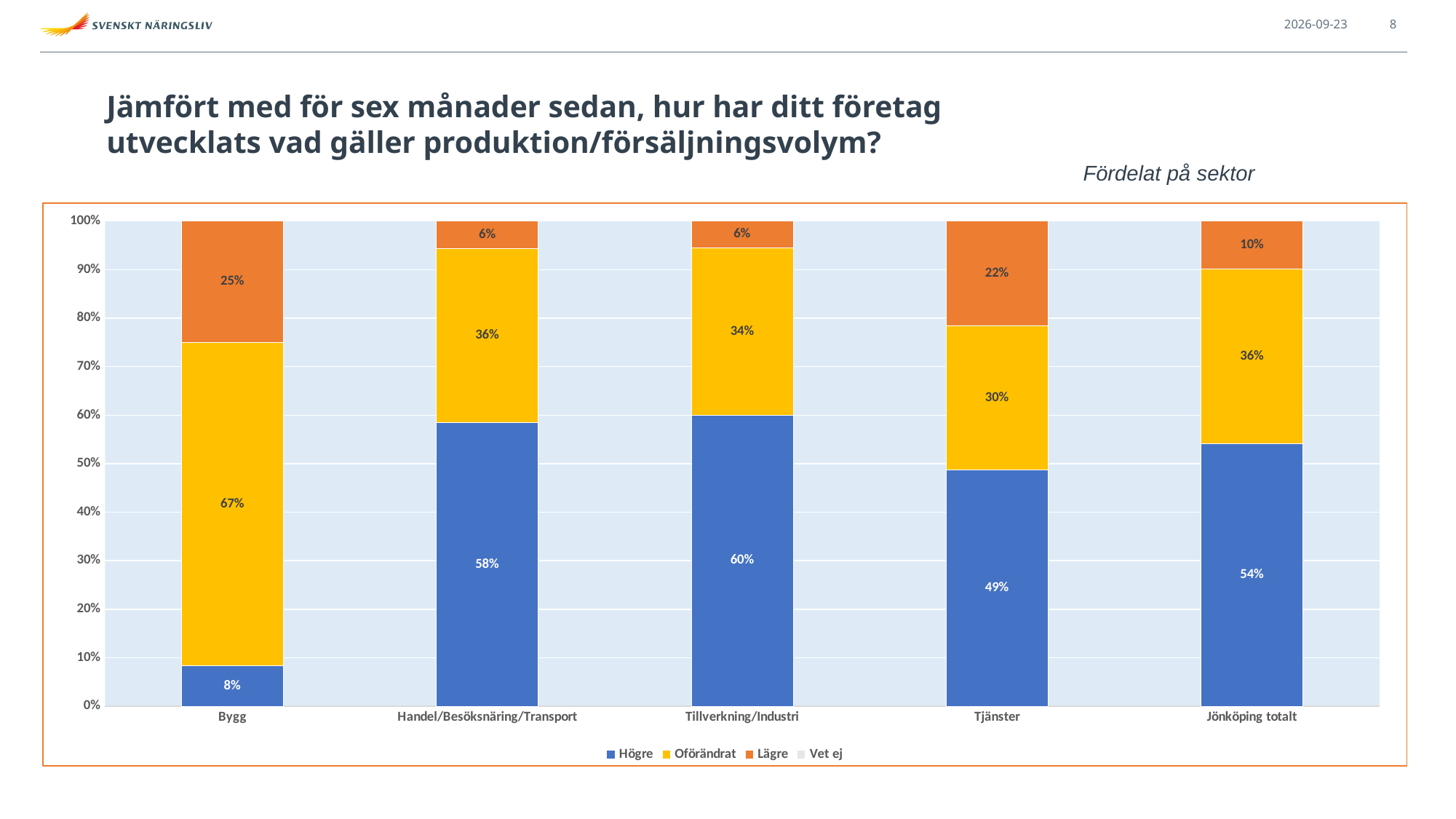
Which sector has the lowest Högre share? Bygg Which sector has the highest Högre share? Tillverkning/Industri Which has a larger Lägre share, Bygg or Tjänster? Bygg What kind of chart is shown on the slide? Stacked bar chart Which sector has the highest Oförändrat share? Bygg What is the Lägre share for Jönköping totalt? 10% What is the Oförändrat share for Tillverkning/Industri? 34% What is the Lägre share for Tjänster? 22% What is the difference in the Högre share between Handel/Besöksnäring/Transport and Tjänster? 9 percentage points How many sectors are shown on the x axis? 5 What percentage of companies in Bygg answered Högre? 8% How many series does the legend list? 4